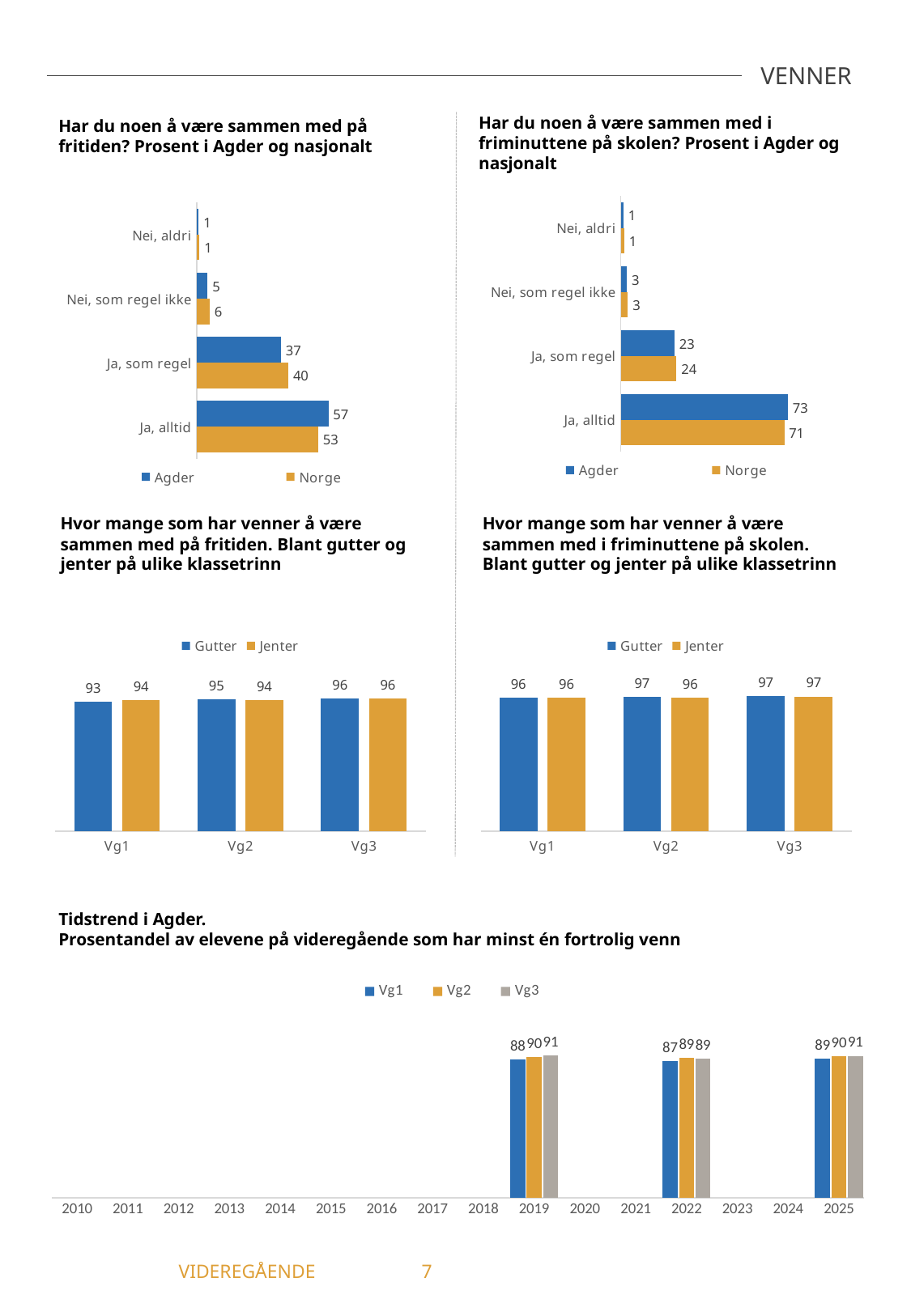
In the chart 'Tidstrend i Agder', what is the difference between Vg3 and Vg1 in 2019? 3 In the chart 'Har du noen å være sammen med på fritiden? Prosent i Agder og nasjonalt', what is the difference between Norge and Agder for 'Ja, som regel'? 3 In the chart 'Har du noen å være sammen med i friminuttene på skolen? Prosent i Agder og nasjonalt', which is larger for 'Ja, som regel': Agder or Norge? Norge In the chart 'Hvor mange som har venner å være sammen med på fritiden. Blant gutter og jenter på ulike klassetrinn', what is the value for Gutter in Vg1? 93 In the chart 'Har du noen å være sammen med på fritiden? Prosent i Agder og nasjonalt', what is the value for Agder in the category 'Ja, alltid'? 57 In the chart 'Hvor mange som har venner å være sammen med på fritiden. Blant gutter og jenter på ulike klassetrinn', do the values for Gutter rise or fall from Vg1 to Vg3? rise In the chart 'Tidstrend i Agder', what is the value for Vg1 in 2022? 87 In the chart 'Har du noen å være sammen med på fritiden? Prosent i Agder og nasjonalt', which category has the highest value for Norge? Ja, alltid In the chart 'Har du noen å være sammen med i friminuttene på skolen? Prosent i Agder og nasjonalt', how many categories are shown? 4 In the chart 'Har du noen å være sammen med i friminuttene på skolen? Prosent i Agder og nasjonalt', what is the value for Norge in the category 'Ja, alltid'? 71 In the chart 'Hvor mange som har venner å være sammen med i friminuttene på skolen. Blant gutter og jenter på ulike klassetrinn', how many series does the legend list? 2 In the chart 'Hvor mange som har venner å være sammen med i friminuttene på skolen. Blant gutter og jenter på ulike klassetrinn', what is the value for Jenter in Vg2? 96